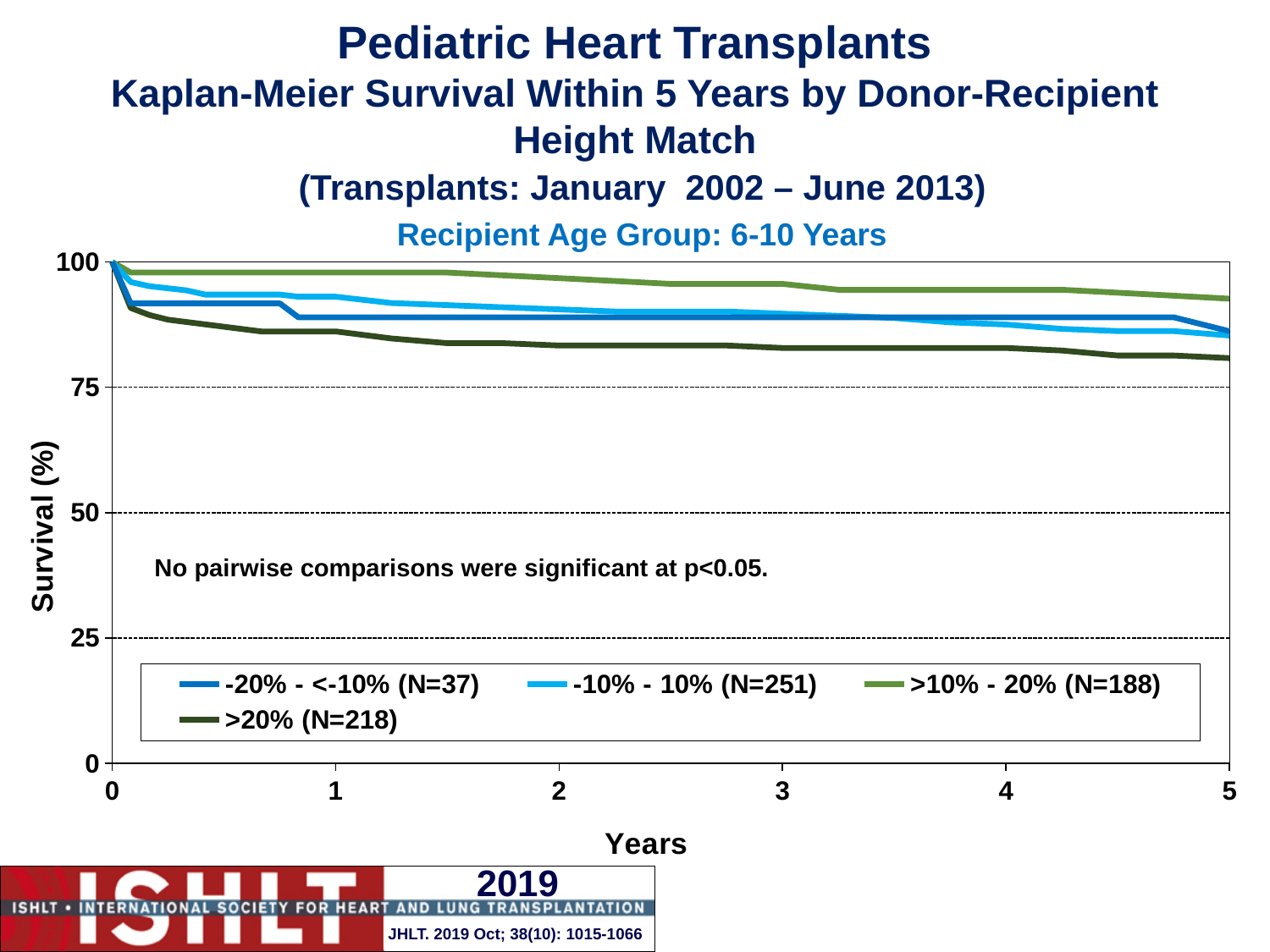
Is the survival value for the >10% - 20% (N=188) group at year 3 greater or less than 75? greater What is the label of the y axis? Survival (%) Do the survival curves rise or fall as years increase along the x axis? fall At year 3, which group has higher survival: >10% - 20% (N=188) or >20% (N=218)? >10% - 20% (N=188) According to the legend, how many patients are in the -10% - 10% group? 251 How many tick marks are labelled on the x axis (Years)? 6 Which height-match group has the lowest survival at year 5? >20% (N=218) Which height-match group has the highest survival at year 5? >10% - 20% (N=188) Is the survival value for the -20% - <-10% (N=37) group at year 2 greater or less than 50? greater How many series does the legend list? 4 What kind of chart is shown on the slide? line chart Is the survival value for the >20% (N=218) group at year 5 greater or less than 75? greater